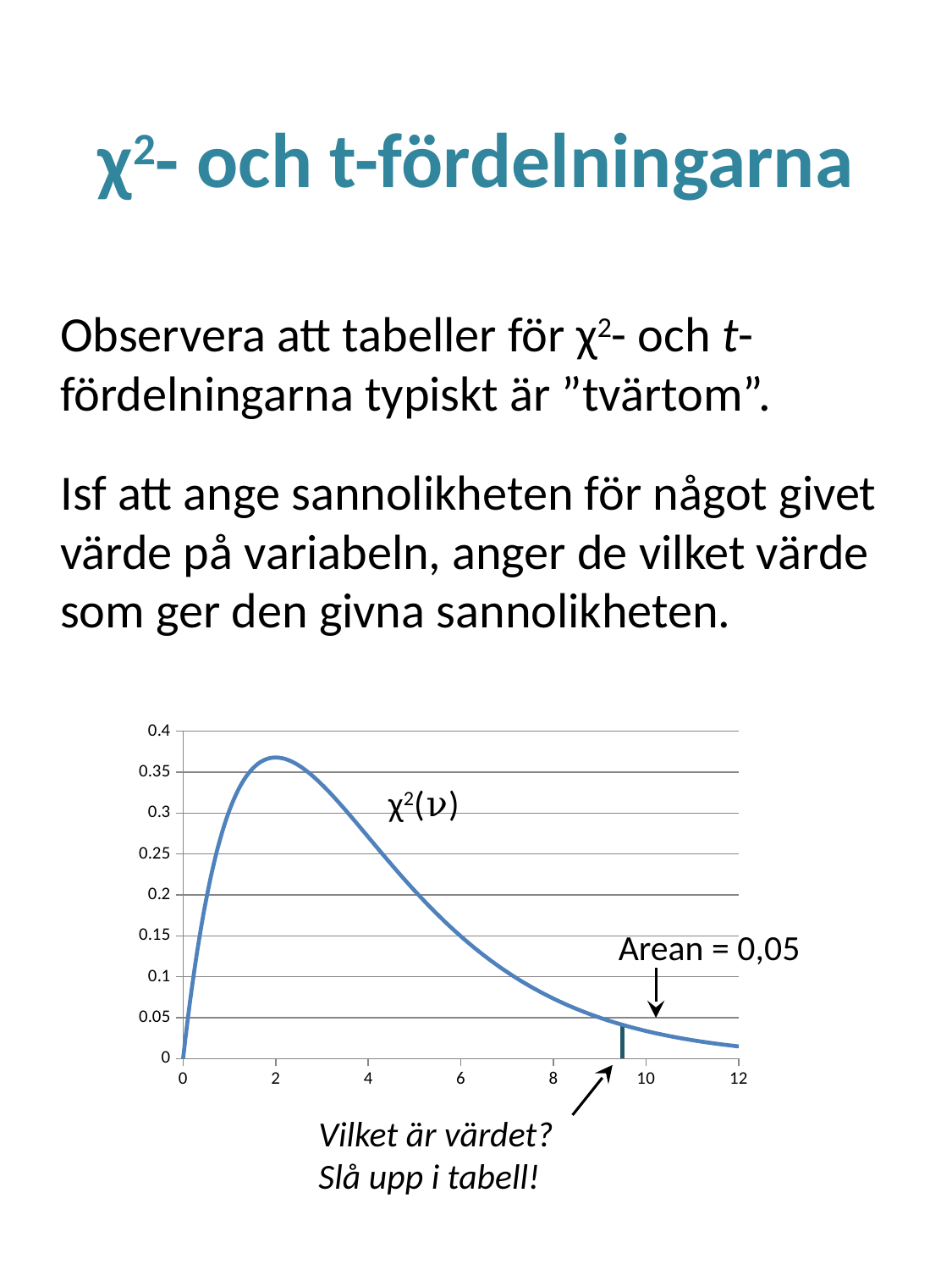
Is the value of the curve at x = 4 greater or less than 0.25? greater What kind of chart is shown on the slide? line chart What label is written next to the curve in the chart? χ²(ν) Between x = 0 and x = 2, does the curve rise or fall? rise Is the value of the curve at x = 12 greater or less than 0.05? less What is the highest tick value shown on the x axis? 12 After the curve reaches its peak near x = 2, does it rise or fall as x increases? fall What does the annotation with the downward arrow near the right tail of the curve say? Arean = 0,05 Is the value of the curve at x = 8 greater or less than 0.1? less Is the value of the curve at x = 2 larger or smaller than the value at x = 10? larger